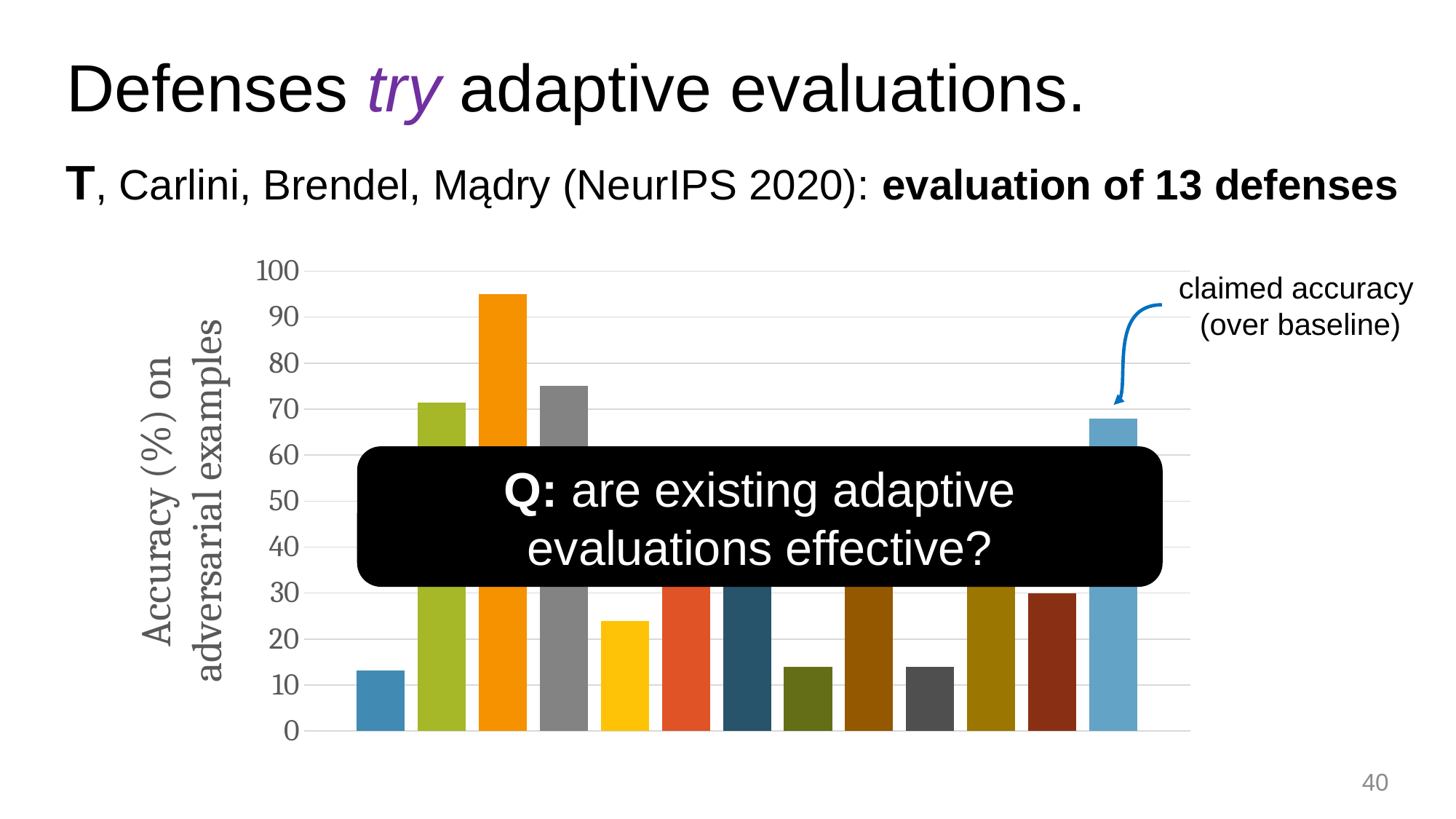
Which is taller, the orange bar (third from the left) or the gray bar (fourth from the left)? the orange bar Which is taller, the first bar from the left or the last bar on the right? the last bar on the right What does the annotation with the arrow pointing to the rightmost bar say? claimed accuracy (over baseline) How many bars are plotted in the chart? 13 Is the value of the last bar on the right greater or less than 60? greater Is the value of the orange bar (third from the left) greater or less than 90? greater Is the value of the yellow bar (fifth from the left) greater or less than 30? less What kind of chart is shown on the slide? bar chart What is the label of the vertical axis of the chart? Accuracy (%) on adversarial examples Which bar is the tallest in the chart? the orange bar (third from the left)